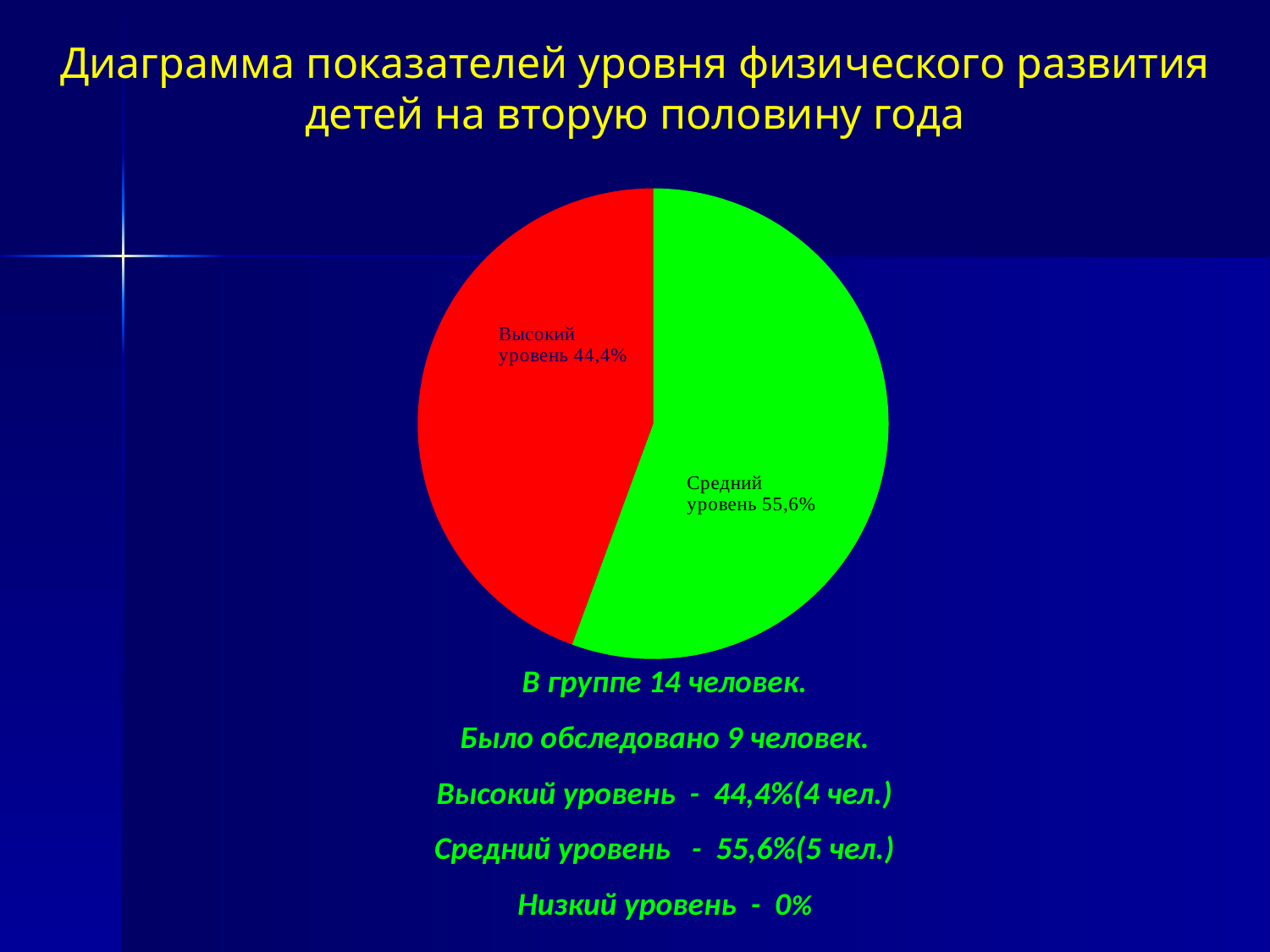
What is the value for Средний уровень? 55,6% Which is larger, Высокий уровень or Средний уровень? Средний уровень What colour is the Высокий уровень slice? red Which slice is the smallest? Высокий уровень What is the difference between Средний уровень and Высокий уровень? 11,2% How many slices does the pie chart have? 2 What colour is the Средний уровень slice? green Which slice is the largest? Средний уровень What share of the pie does Средний уровень take? 55,6% What kind of chart is shown on the slide? pie chart What is the value for Высокий уровень? 44,4%